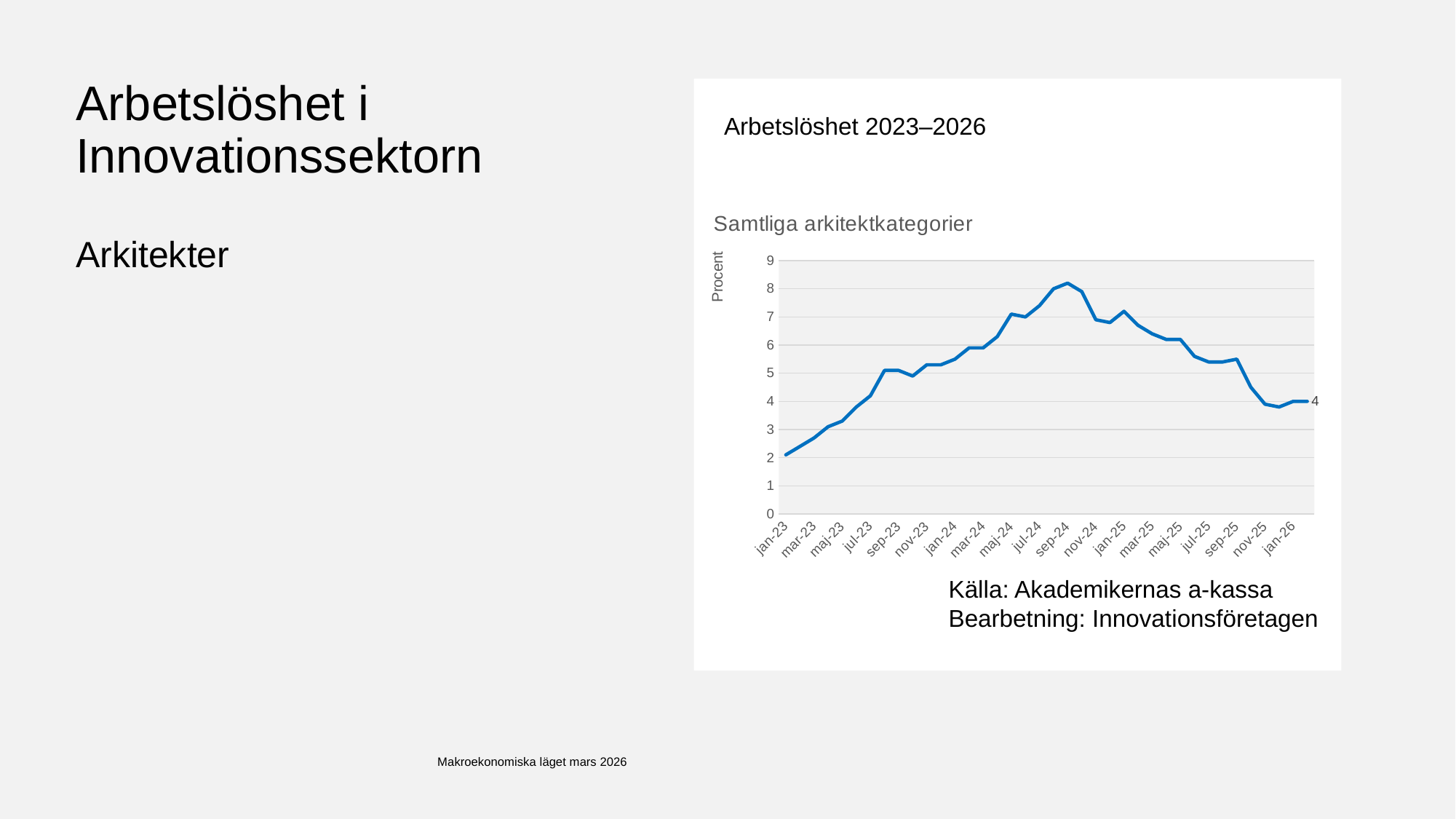
Which is larger, the value for sep-24 or the value for sep-25? sep-24 Is the value for jan-23 greater or less than 3? less Is the value for sep-24 greater or less than 7? greater What kind of chart is shown on the slide? line chart What is the title shown directly above the chart's plot area? Samtliga arkitektkategorier Around which month does the line reach its highest value? sep-24 What is the label on the vertical axis? Procent Does the line rise or fall between sep-24 and nov-25? fall At which month is the line at its lowest value? jan-23 Is the value for nov-25 greater or less than 5? less What value is printed as the data label at the end of the line (the latest point)? 4